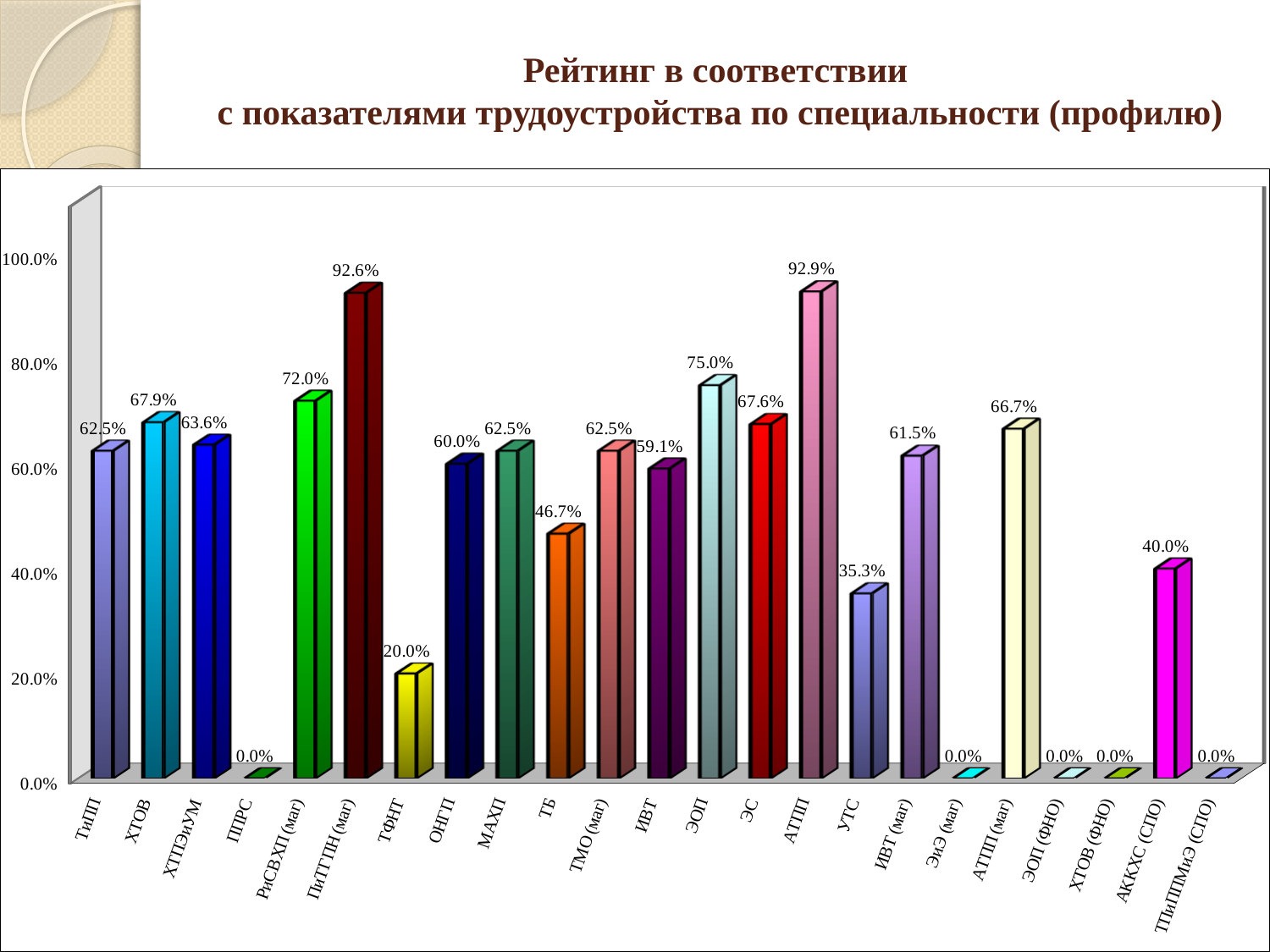
Which category has the highest value? АТПП What is the value for ТФНТ? 20.0% What is the value for УТС? 35.3% What is the difference between the values for ЭОП and ОНГП? 15.0% Is the value for АТПП (маг) greater or less than 80.0%? less What is the difference between the values for ПиТГПН (маг) and ТФНТ? 72.6% What is the value for АККХС (СПО)? 40.0% How many categories are shown on the x axis? 23 Which is larger, the value for ТБ or the value for УТС? ТБ How many categories have a value of 0.0%? 5 What kind of chart is shown on the slide? bar chart What is the value for ПиТГПН (маг)? 92.6%